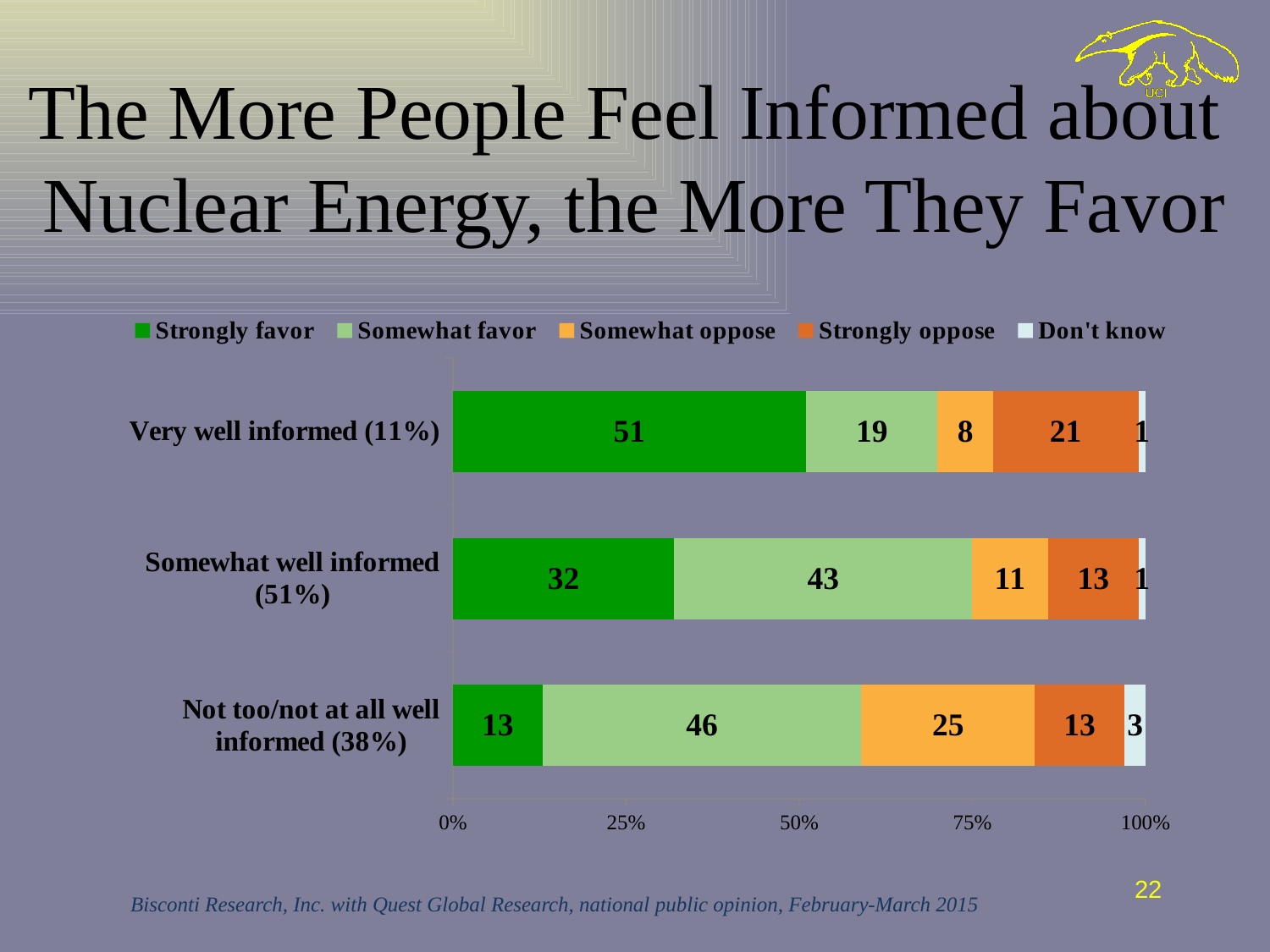
What is the Somewhat favor value for the Somewhat well informed (51%) group? 43 What is the Somewhat oppose value for the Not too/not at all well informed (38%) group? 25 Which group has the lowest Strongly favor value? Not too/not at all well informed (38%) How many categories (bars) are shown in the chart? 3 What is the total of the stacked bar for the Somewhat well informed (51%) group? 100 Which is larger: the Somewhat oppose value for the Somewhat well informed (51%) group or for the Not too/not at all well informed (38%) group? Not too/not at all well informed (38%) Which group has the highest Strongly favor value? Very well informed (11%) What is the difference between the Strongly favor values for the Very well informed (11%) group and the Not too/not at all well informed (38%) group? 38 How many series does the legend list? 5 What is the Strongly favor value for the Very well informed (11%) group? 51 What is the Strongly oppose value for the Very well informed (11%) group? 21 What kind of chart is shown on the slide? Stacked bar chart